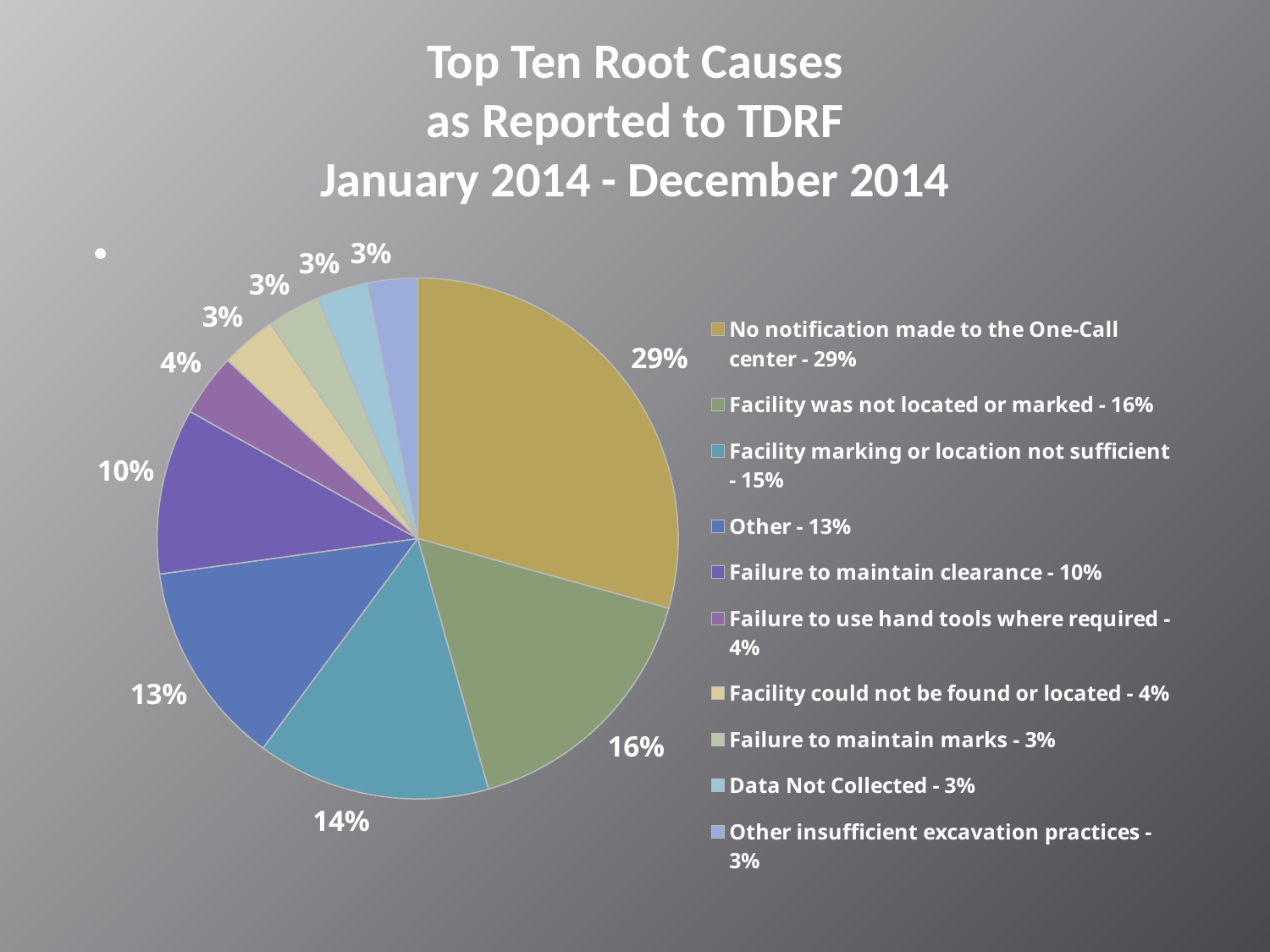
What time period does the chart title say the data covers? January 2014 - December 2014 What percentage is shown for 'No notification made to the One-Call center'? 29% Which is larger: 'Other' or 'Failure to maintain clearance'? Other What kind of chart is shown on the slide? Pie chart Which root cause has the largest share of the pie? No notification made to the One-Call center What percentage is shown for 'Failure to use hand tools where required'? 4% What is the difference in percentage points between 'No notification made to the One-Call center' and 'Facility was not located or marked'? 13 percentage points What share of the pie does 'Failure to maintain clearance' represent? 10% How many slices does the pie chart have? 10 What percentage is shown for 'Other'? 13% What percentage is shown for 'Facility was not located or marked'? 16% What percentage is shown for 'Failure to maintain clearance'? 10%